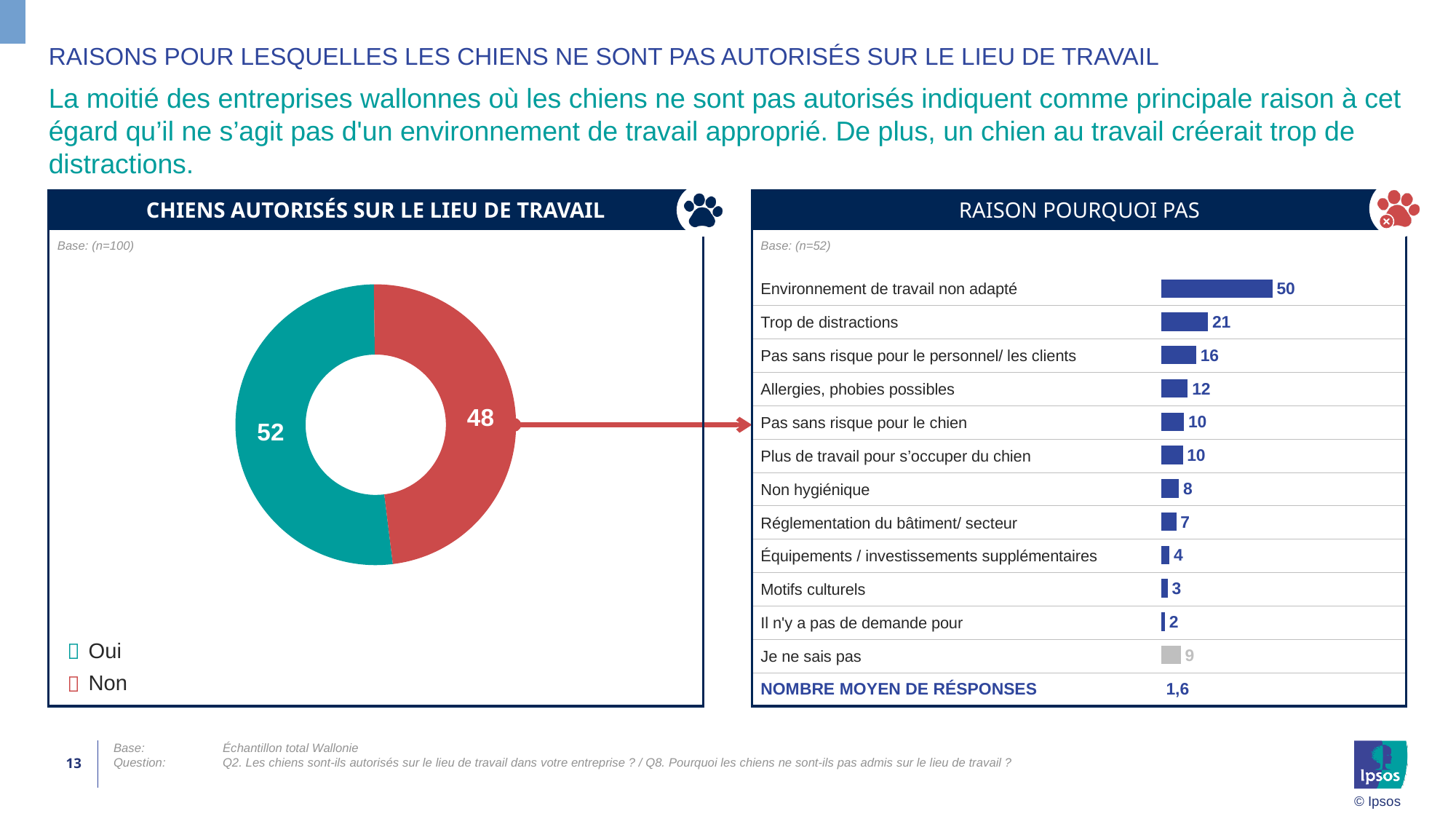
In the 'CHIENS AUTORISÉS SUR LE LIEU DE TRAVAIL' chart, what is the difference between Oui and Non? 4 In the 'RAISON POURQUOI PAS' chart, what kind of chart is used? Bar chart In the 'CHIENS AUTORISÉS SUR LE LIEU DE TRAVAIL' chart, what is the value for Oui? 52 In the 'RAISON POURQUOI PAS' chart, what is the value for 'Je ne sais pas'? 9 In the 'CHIENS AUTORISÉS SUR LE LIEU DE TRAVAIL' chart, what is the value for Non? 48 In the 'CHIENS AUTORISÉS SUR LE LIEU DE TRAVAIL' chart, which is larger, Oui or Non? Oui In the 'RAISON POURQUOI PAS' chart, what is the difference between 'Environnement de travail non adapté' and 'Trop de distractions'? 29 In the 'RAISON POURQUOI PAS' chart, which reason has the highest value? Environnement de travail non adapté In the 'RAISON POURQUOI PAS' chart, what is the value for 'Trop de distractions'? 21 In the 'RAISON POURQUOI PAS' chart, which reason has the lowest value? Il n'y a pas de demande pour In the 'RAISON POURQUOI PAS' chart, what is the value for 'Allergies, phobies possibles'? 12 What kind of chart is 'CHIENS AUTORISÉS SUR LE LIEU DE TRAVAIL'? Donut (pie) chart